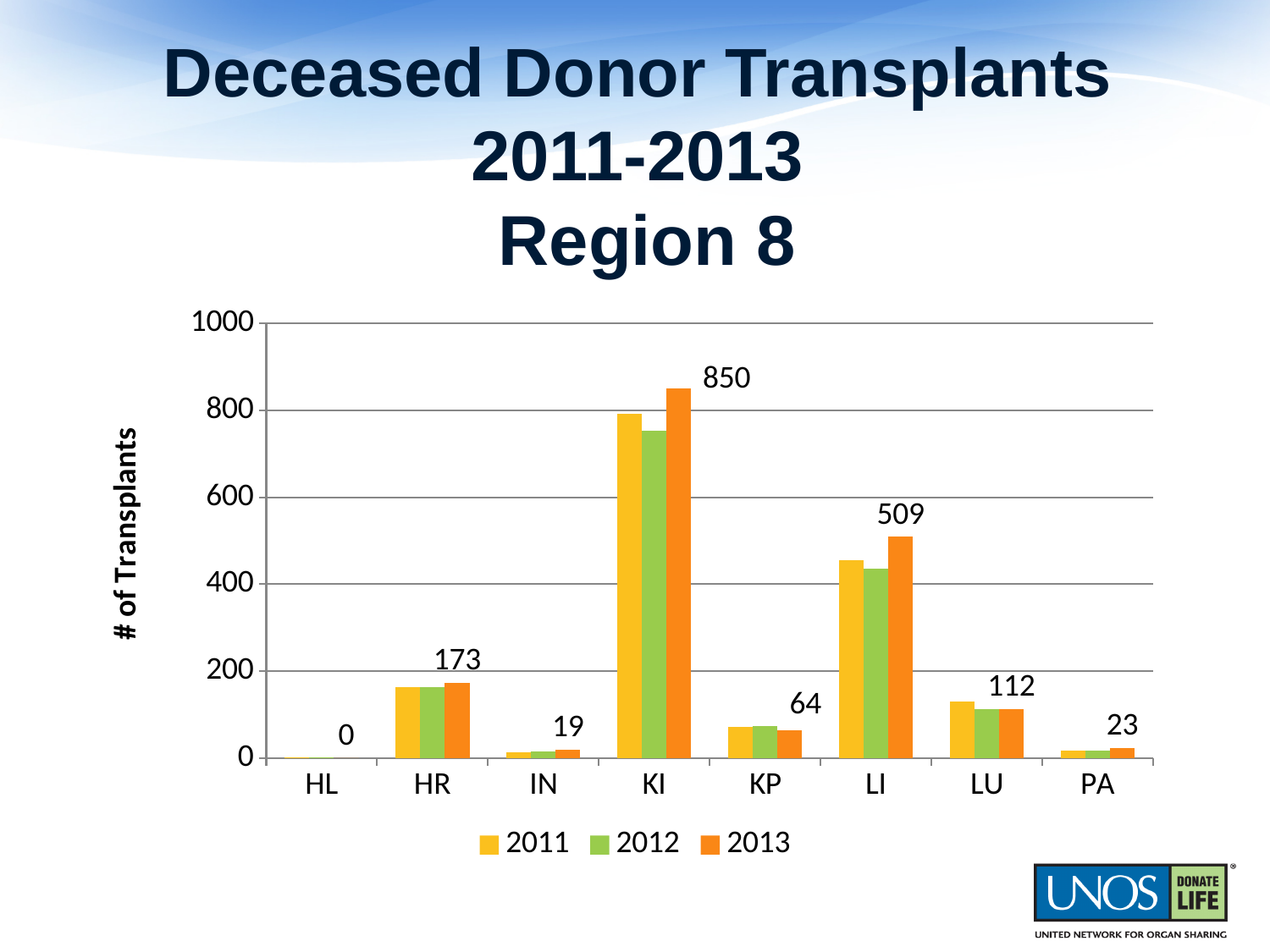
How many series does the legend list? 3 Which is larger in 2013, the value for KP or the value for LU? LU Which organ category has the lowest number of transplants in 2013? HL What is the difference between the 2013 values for KI and LI? 341 What is the value for HR in 2013? 173 Is the value for KI in 2012 greater or less than 600? greater What is the value for KI in 2013? 850 What is the value for PA in 2013? 23 What kind of chart is shown on the slide? Bar chart How many organ categories are shown on the x axis? 8 Which organ category has the highest number of transplants in 2013? KI What is the value for LI in 2013? 509